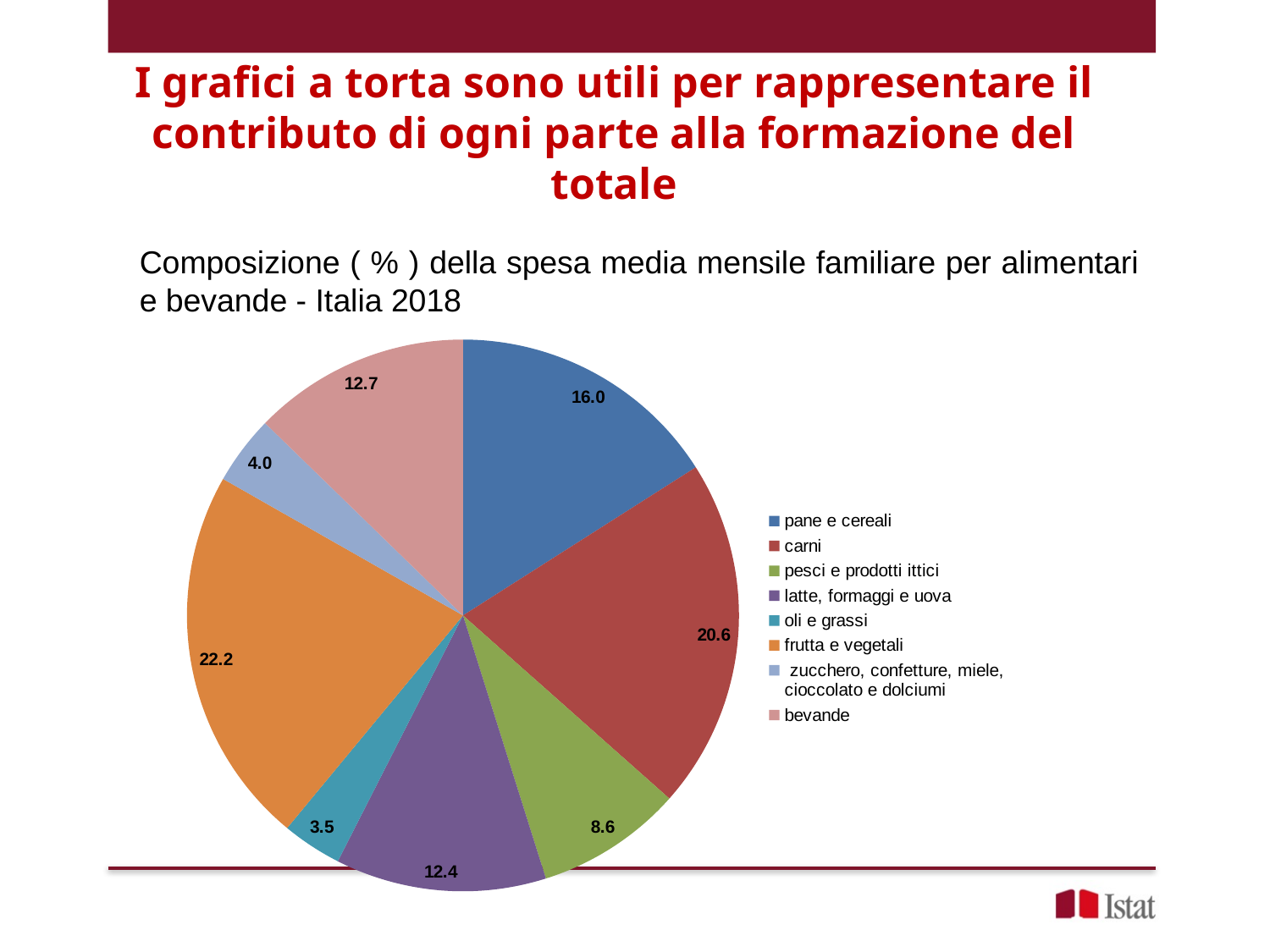
Which category has the largest slice of the pie chart? frutta e vegetali Which is larger, the value for latte, formaggi e uova or the value for pesci e prodotti ittici? latte, formaggi e uova What is the value for carni in the pie chart? 20.6 What kind of chart is shown on the slide? pie chart What is the value for oli e grassi in the pie chart? 3.5 How many slices does the pie chart have? 8 What is the difference between the values for frutta e vegetali and pane e cereali? 6.2 What is the value for bevande in the pie chart? 12.7 Which category has the smallest slice of the pie chart? oli e grassi How many entries does the legend of the pie chart list? 8 What is the value for frutta e vegetali in the pie chart? 22.2 What is the value for zucchero, confetture, miele, cioccolato e dolciumi in the pie chart? 4.0